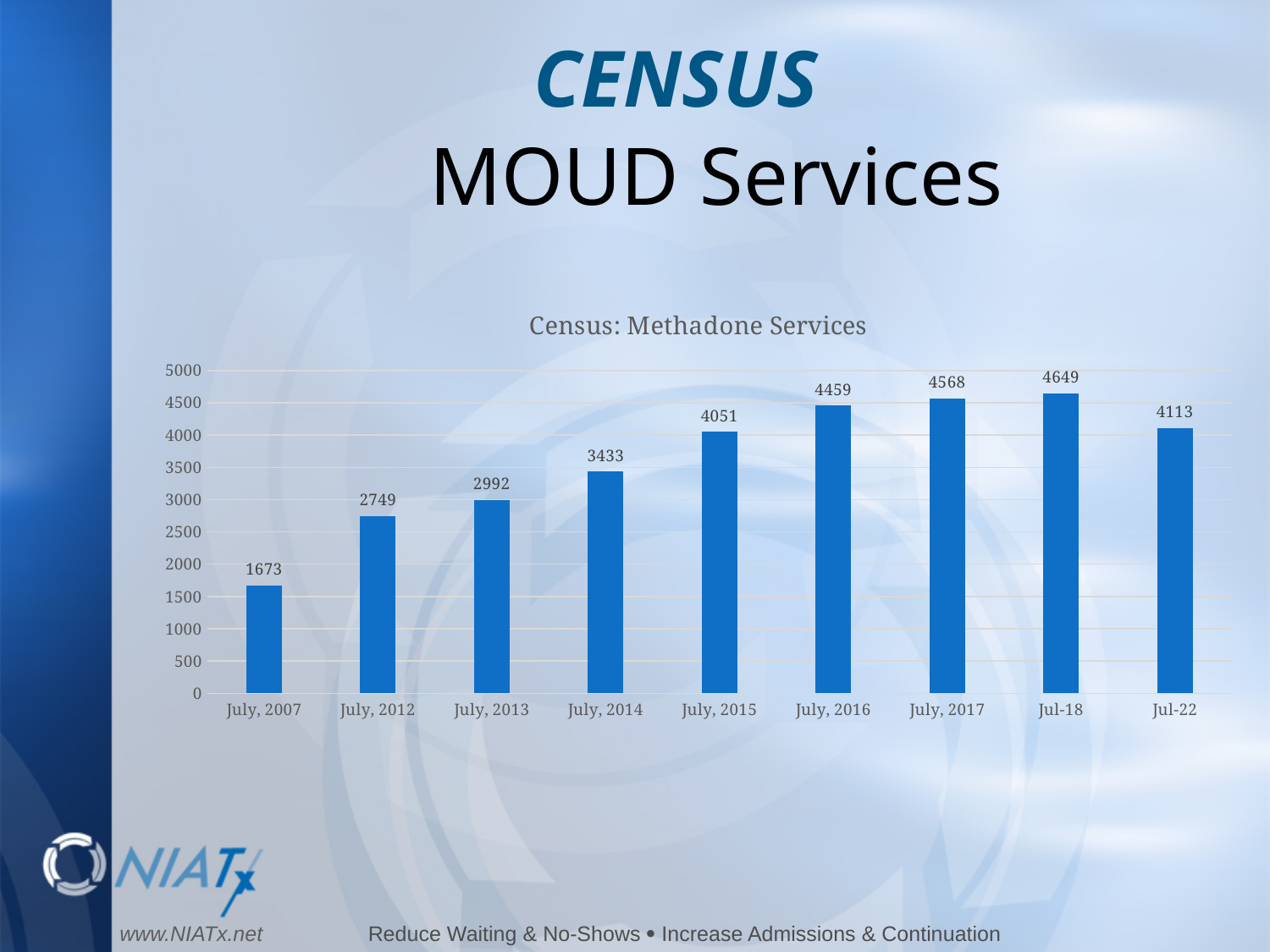
Which category has the lowest value? July, 2007 What is the difference between the values for Jul-18 and Jul-22? 536 What is the value for July, 2015? 4051 Which category has the highest value? Jul-18 Which is larger, the value for July, 2016 or the value for Jul-22? July, 2016 What is the value for July, 2007? 1673 What is the title of the chart? Census: Methadone Services What is the difference between the values for July, 2012 and July, 2007? 1076 What is the value for Jul-22? 4113 Is the value for July, 2014 greater or less than 3000? greater What kind of chart is shown? bar chart How many categories are shown on the x axis? 9